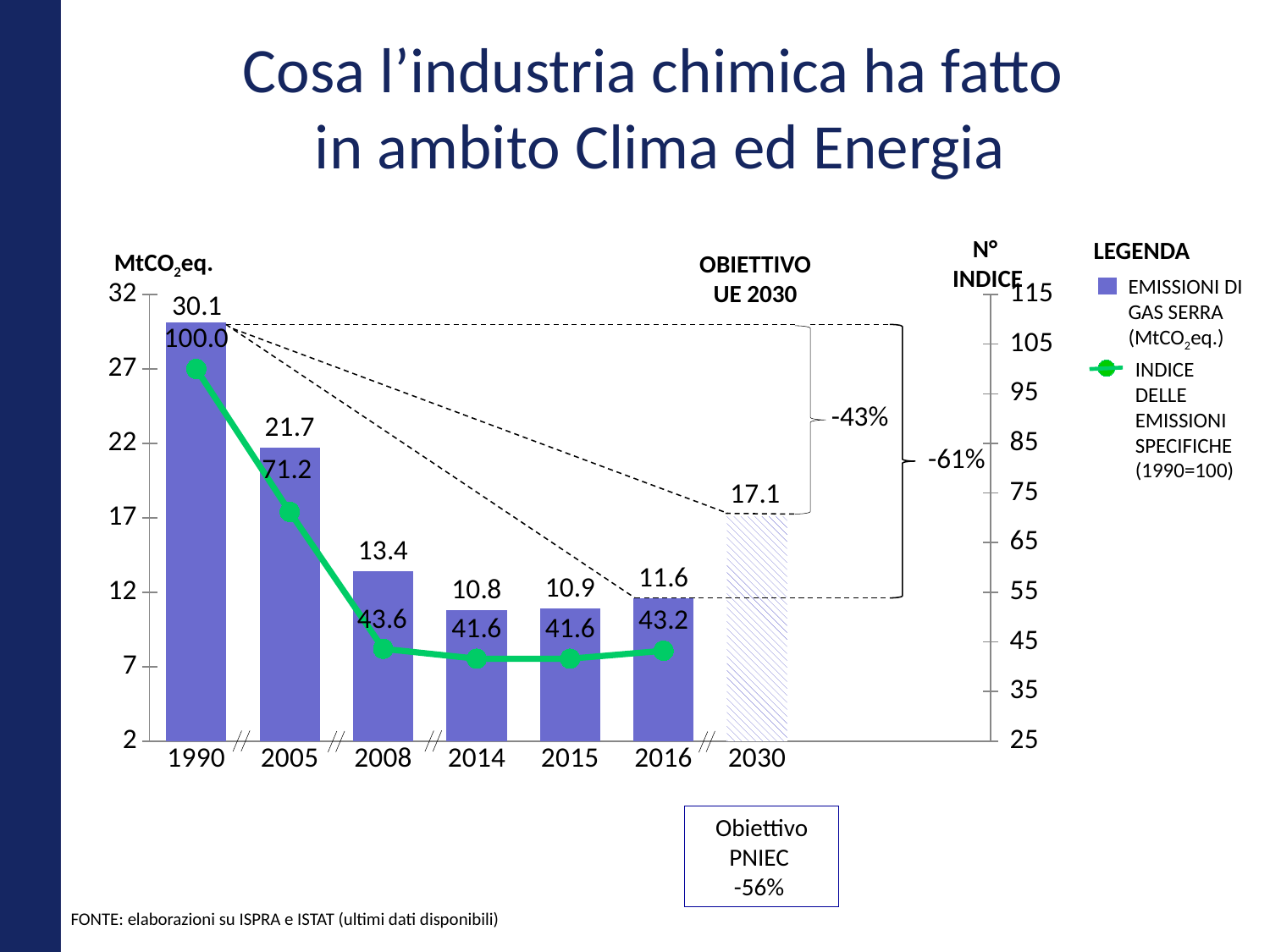
What is the difference between the emissions values for 1990 and 2016? 18.5 What emissions value is shown for the 2030 EU objective (OBIETTIVO UE 2030)? 17.1 What is the overall trend of the specific emissions index from 1990 to 2016? Falling Is the emissions value for 2008 larger than the value for 2015? Yes, 2008 (13.4) is larger than 2015 (10.9) What is the greenhouse gas emissions value (MtCO2eq.) shown for 1990? 30.1 Which year has the highest greenhouse gas emissions value? 1990 What percentage reduction is indicated by the bracket between the 1990 level and the 2016 level? -61% What is the greenhouse gas emissions value (MtCO2eq.) shown for 2016? 11.6 What is the value of the specific emissions index (1990=100) for 2005? 71.2 Which year has the lowest greenhouse gas emissions value among the solid bars? 2014 How many years are labelled on the x axis of the chart? 7 How many series does the legend (LEGENDA) list? 2